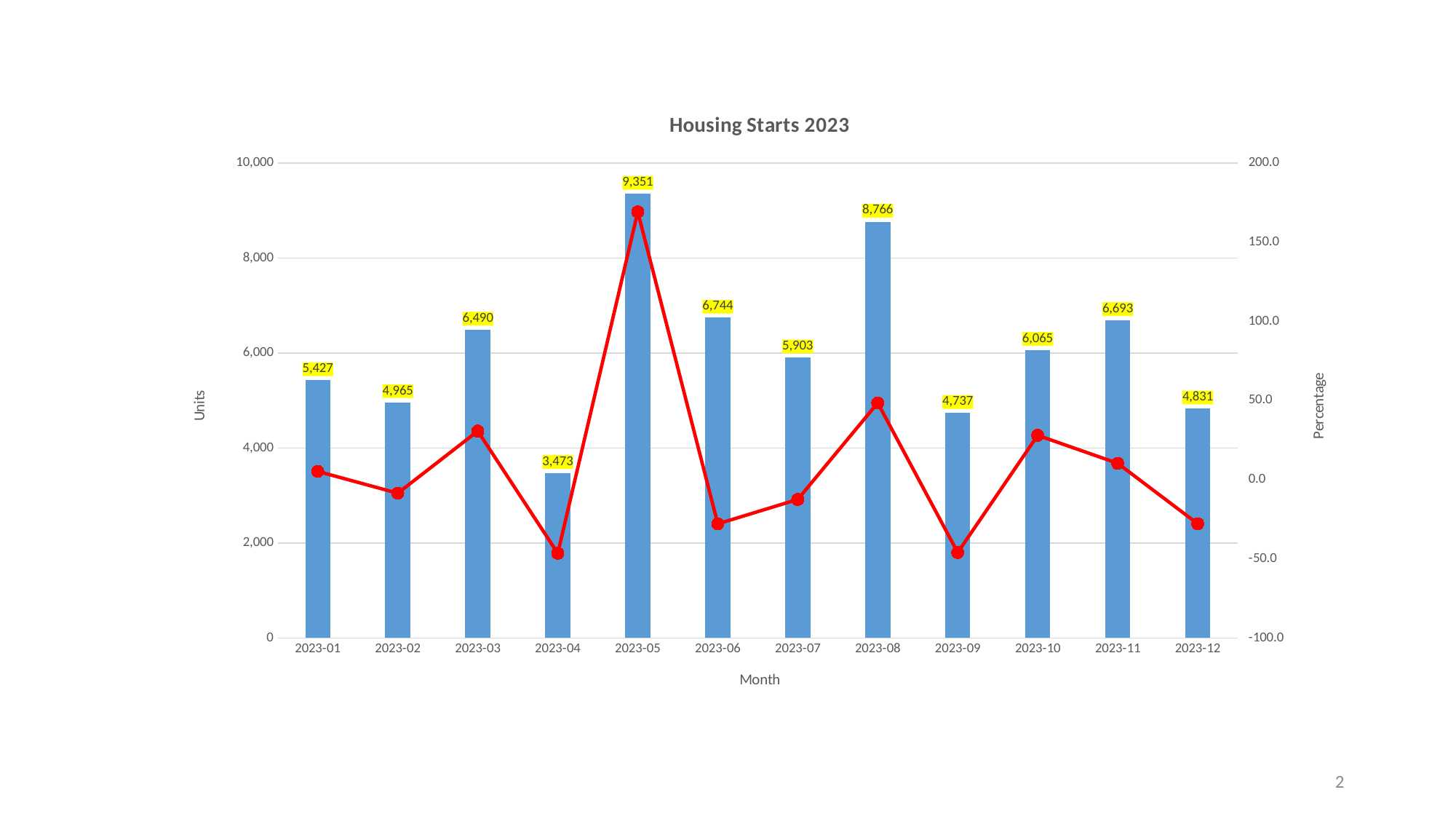
Which month has more units, 2023-03 or 2023-11? 2023-11 Is the percentage value (red line) for 2023-09 greater or less than 0.0? less How many months are shown on the x axis? 12 Which month has the lowest number of units? 2023-04 What is the difference in units between 2023-05 and 2023-04? 5,878 What is the label of the right-hand vertical axis? Percentage What is the number of units for 2023-09? 4,737 Which month has the highest number of units? 2023-05 What is the difference in units between 2023-08 and 2023-06? 2,022 What is the number of units for 2023-05? 9,351 What is the title of the chart? Housing Starts 2023 Is the percentage value (red line) for 2023-05 greater or less than 150.0? greater